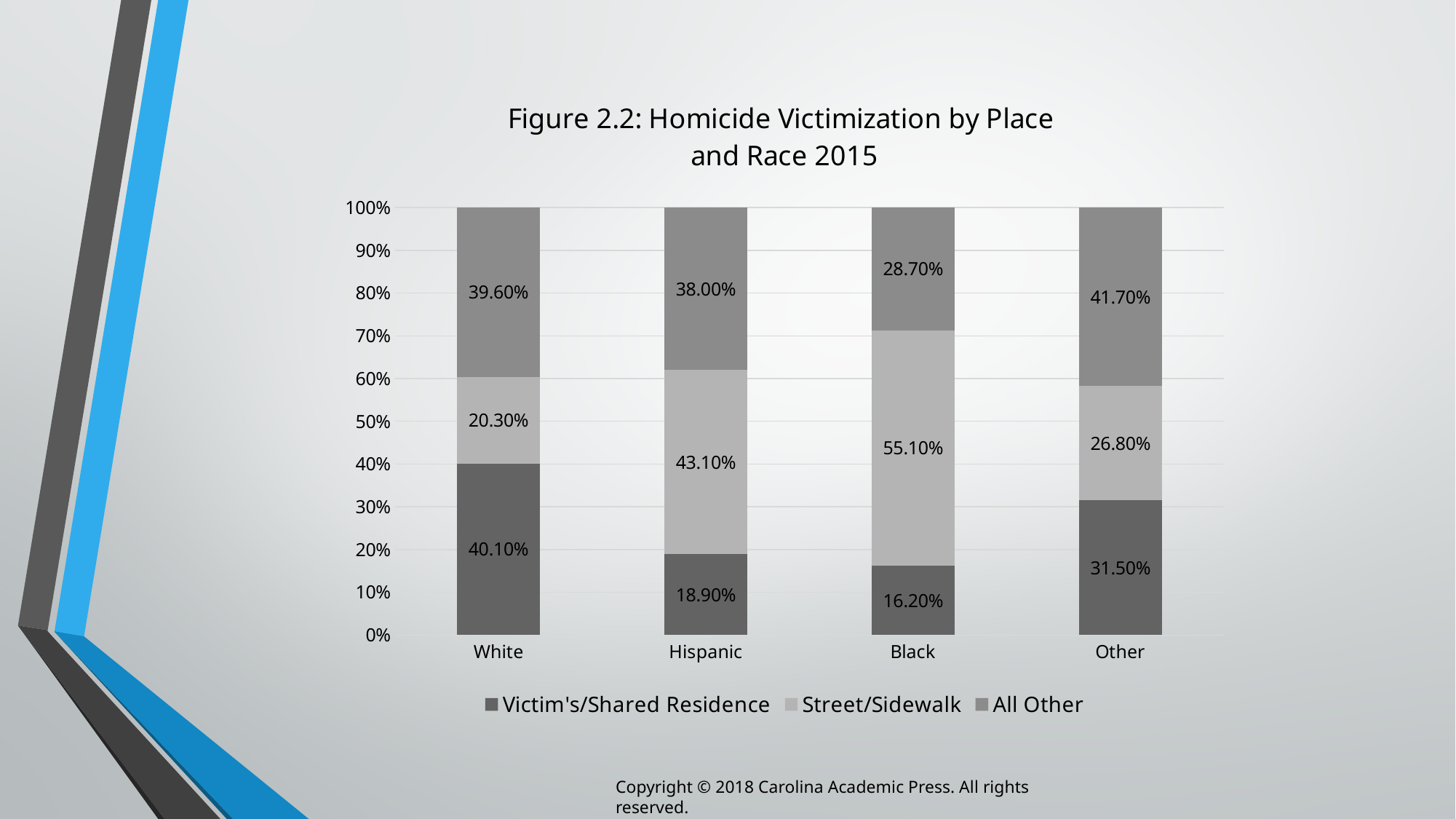
What is the All Other value for Other? 41.70% Which is larger, the All Other value for White or the All Other value for Hispanic? White What is the title of the chart? Figure 2.2: Homicide Victimization by Place and Race 2015 What is the Victim's/Shared Residence value for Hispanic? 18.90% How many series does the legend list? 3 What kind of chart is shown on the slide? Stacked bar chart What is the Victim's/Shared Residence value for White? 40.10% Which race category has the highest Street/Sidewalk value? Black How many race categories are shown on the x axis? 4 What is the Street/Sidewalk value for Black? 55.10% What is the difference between the Street/Sidewalk values for Hispanic and White? 22.80% Which race category has the lowest Victim's/Shared Residence value? Black